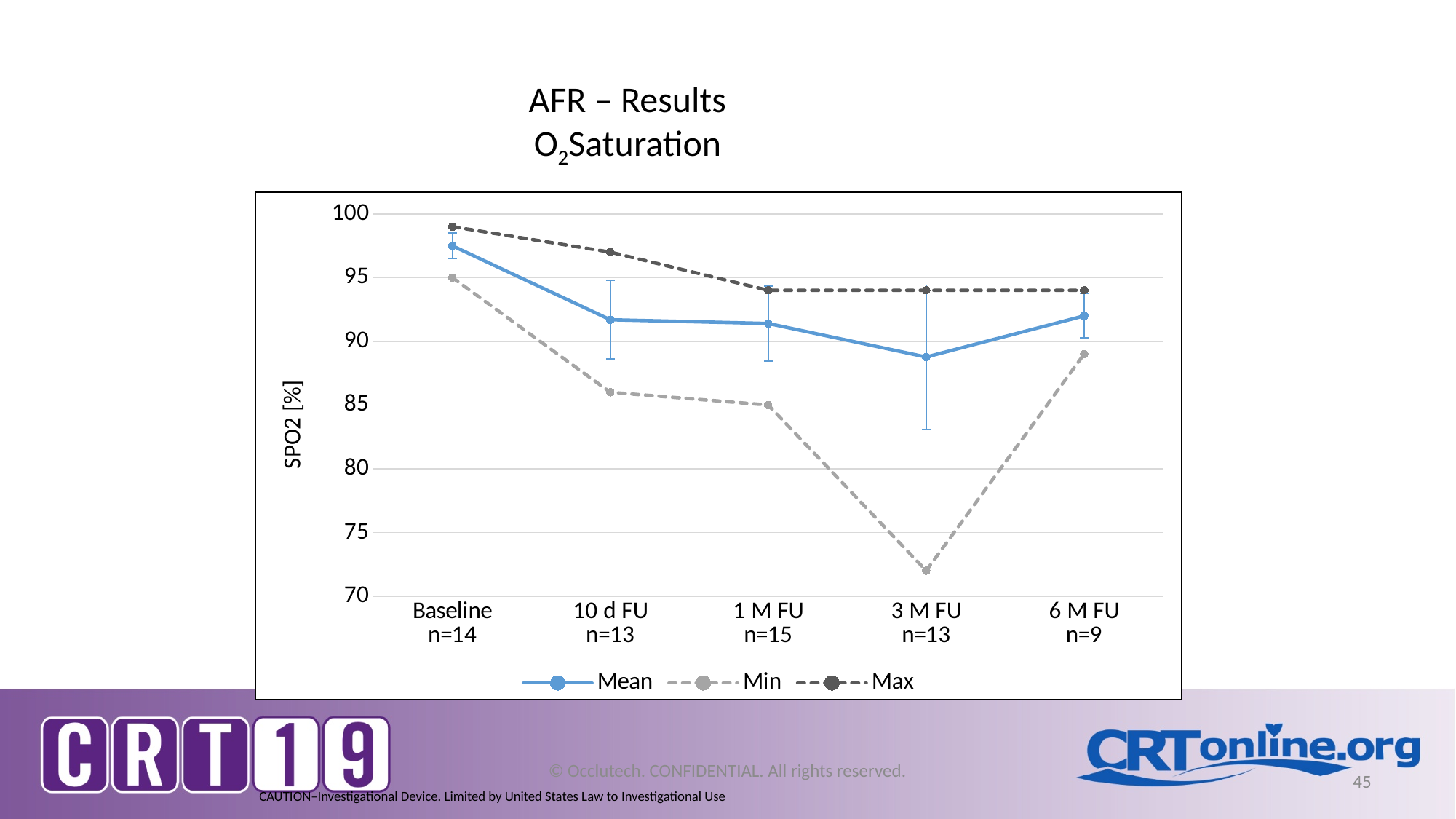
How many series does the legend list? 3 Is the Min value at 3 M FU greater or less than 75? less Does the Min series rise or fall from Baseline to 3 M FU? fall What kind of chart is shown on the slide? line chart What is the n value shown for the 1 M FU time point? n=15 What is the label of the y axis? SPO2 [%] At which time point is the Min series lowest? 3 M FU Is the Mean value at Baseline greater or less than 95? greater What is the Min value at 1 M FU? 85 How many time points are plotted along the x axis? 5 At which time point is the Max series highest? Baseline Is the Mean value at 3 M FU greater or less than 90? less